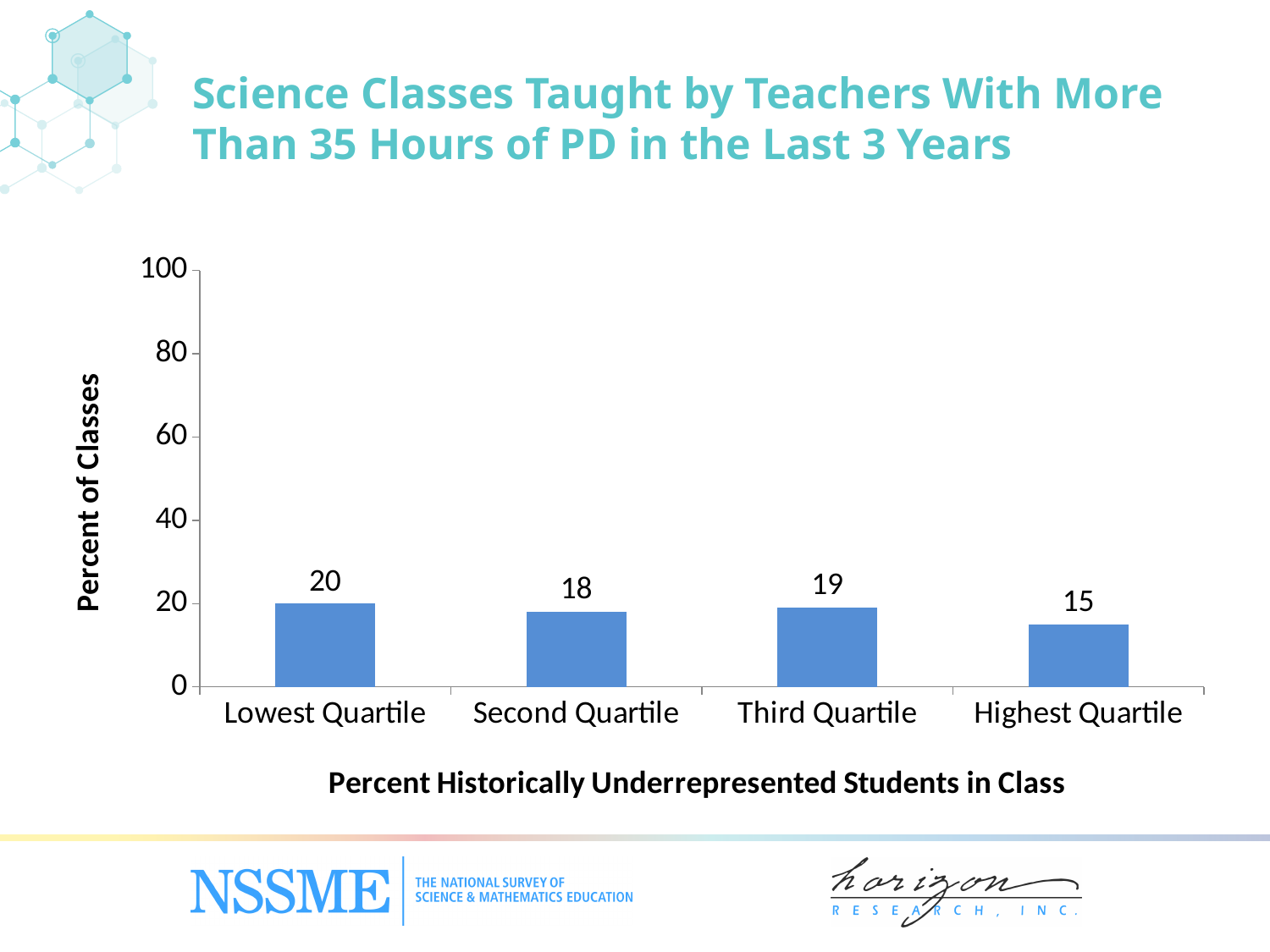
How many categories are shown on the x axis? 4 Which is larger, the value for Second Quartile or the value for Highest Quartile? Second Quartile Is the value for Third Quartile greater or less than 40? less What is the value for Third Quartile? 19 Which category has the lowest value? Highest Quartile What is the value for Highest Quartile? 15 What is the value for Lowest Quartile? 20 Which category has the highest value? Lowest Quartile What is the difference between the values for Lowest Quartile and Highest Quartile? 5 What is the value for Second Quartile? 18 What kind of chart is shown on the slide? bar chart What is the label of the y axis? Percent of Classes